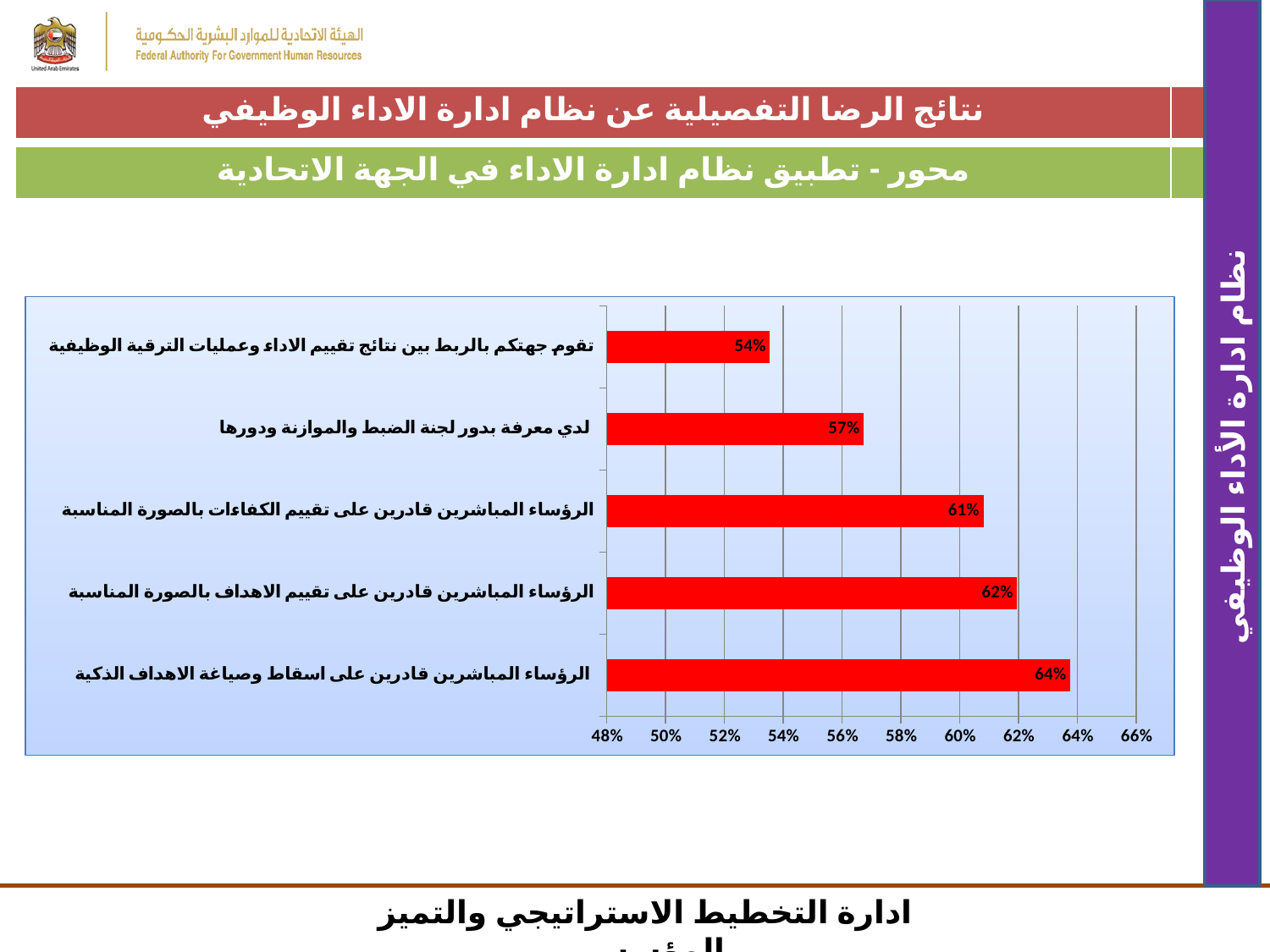
Which category has the lowest value? تقوم جهتكم بالربط بين نتائج تقييم الاداء وعمليات الترقية الوظيفية What is the value for "الرؤساء المباشرين قادرين على تقييم الكفاءات بالصورة المناسبة"? 61% What kind of chart is shown on the slide? bar chart What is the value for "الرؤساء المباشرين قادرين على اسقاط وصياغة الاهداف الذكية"? 64% What is the value for "تقوم جهتكم بالربط بين نتائج تقييم الاداء وعمليات الترقية الوظيفية"? 54% How many categories are shown in the chart? 5 Is the value for "الرؤساء المباشرين قادرين على تقييم الكفاءات بالصورة المناسبة" greater or less than 58%? greater What is the value for "لدي معرفة بدور لجنة الضبط والموازنة ودورها"? 57% Which is larger: the value for "لدي معرفة بدور لجنة الضبط والموازنة ودورها" or the value for "الرؤساء المباشرين قادرين على تقييم الاهداف بالصورة المناسبة"? الرؤساء المباشرين قادرين على تقييم الاهداف بالصورة المناسبة What is the difference between the value for "الرؤساء المباشرين قادرين على اسقاط وصياغة الاهداف الذكية" and the value for "تقوم جهتكم بالربط بين نتائج تقييم الاداء وعمليات الترقية الوظيفية"? 10% What is the highest value shown on the horizontal axis of the chart? 66% Which category has the highest value? الرؤساء المباشرين قادرين على اسقاط وصياغة الاهداف الذكية